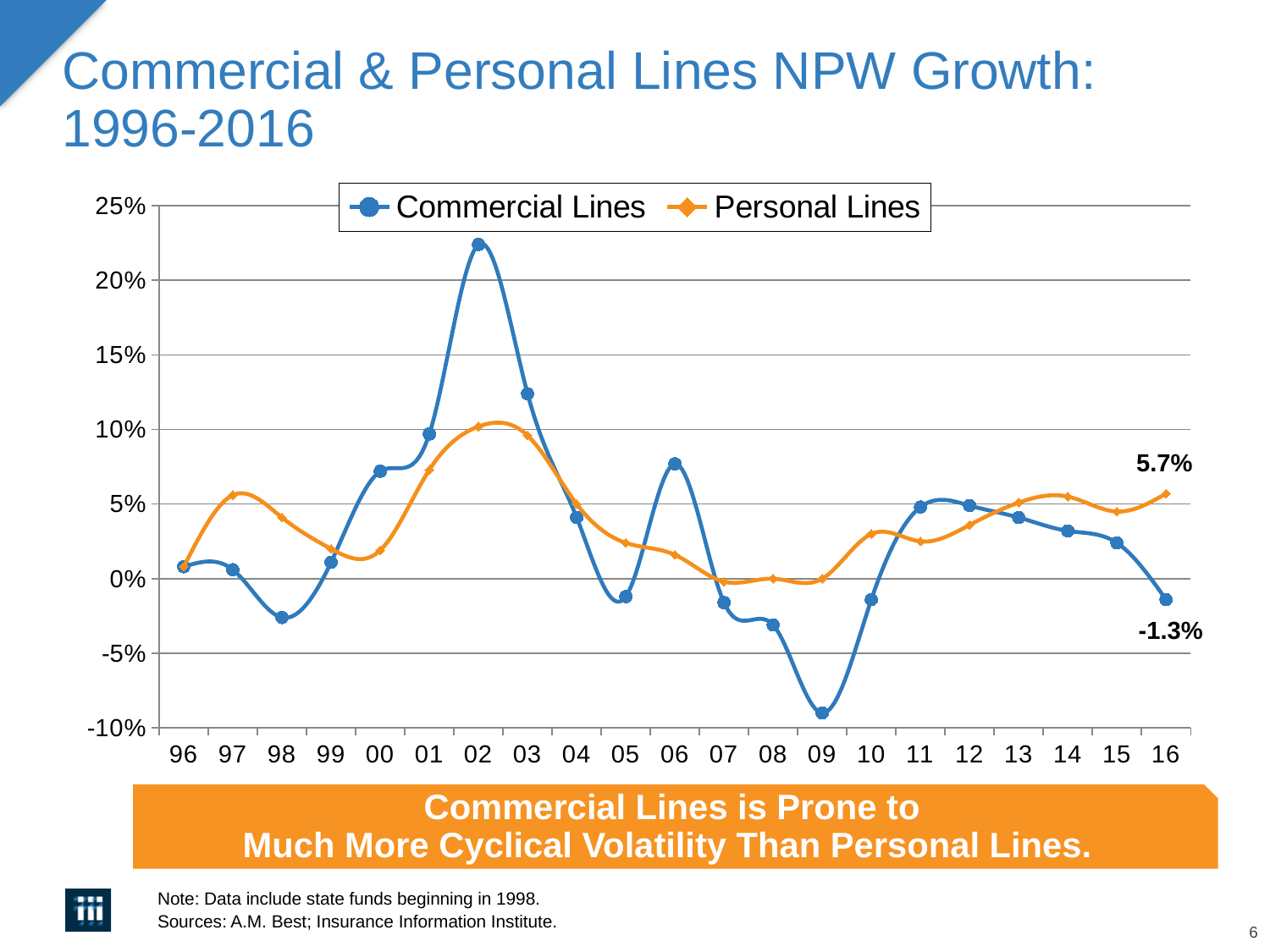
In which year does the Commercial Lines series reach its lowest value? 09 Is the Commercial Lines value for 02 greater or less than 20%? greater In which year does the Commercial Lines series reach its highest value? 02 What kind of chart is shown on the slide? line chart What is the difference between the Personal Lines and Commercial Lines values labelled for 2016? 7.0 percentage points In 2016, which series has the larger value, Commercial Lines or Personal Lines? Personal Lines What is the Personal Lines NPW growth value labelled for 2016 (16)? 5.7% How many years are shown along the x axis? 21 How many series does the legend list? 2 What is the Commercial Lines NPW growth value labelled for 2016 (16)? -1.3% Is the Commercial Lines value for 09 greater or less than -5%? less Does the Commercial Lines series rise or fall from 12 to 16? fall